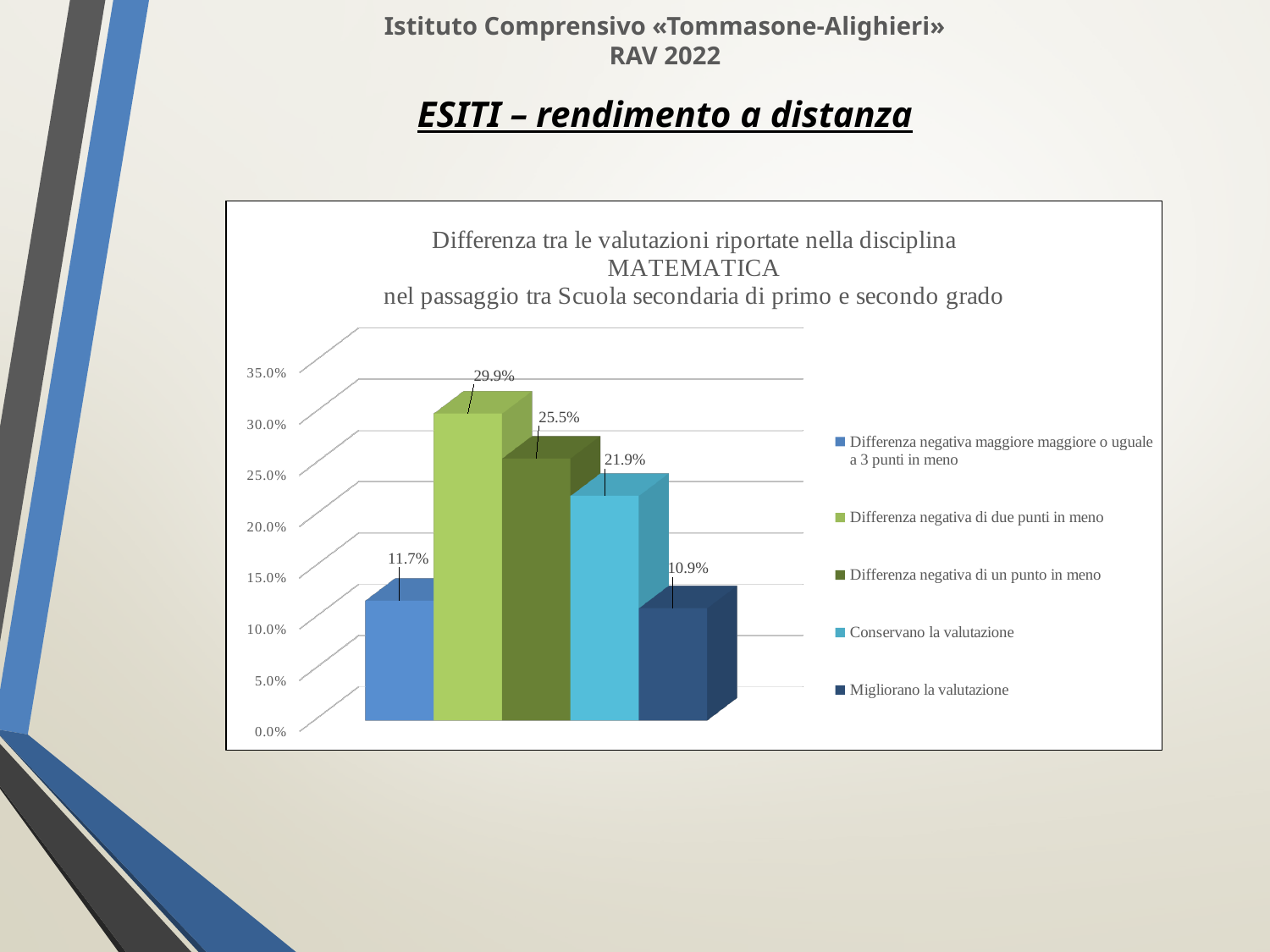
Which category has the lowest value? Migliorano la valutazione Is the value for "Conservano la valutazione" greater or less than 20.0%? greater How many categories does the legend list? 5 Which discipline is named in the chart title? MATEMATICA What is the value for "Differenza negativa di un punto in meno"? 25.5% What is the difference between the values for "Differenza negativa di due punti in meno" and "Differenza negativa di un punto in meno"? 4.4% Which is larger: the value for "Differenza negativa maggiore maggiore o uguale a 3 punti in meno" or the value for "Migliorano la valutazione"? Differenza negativa maggiore maggiore o uguale a 3 punti in meno What is the value for "Migliorano la valutazione"? 10.9% What is the value for "Differenza negativa di due punti in meno"? 29.9% What is the value for "Conservano la valutazione"? 21.9% What kind of chart is shown on the slide? bar chart Which category has the highest value? Differenza negativa di due punti in meno